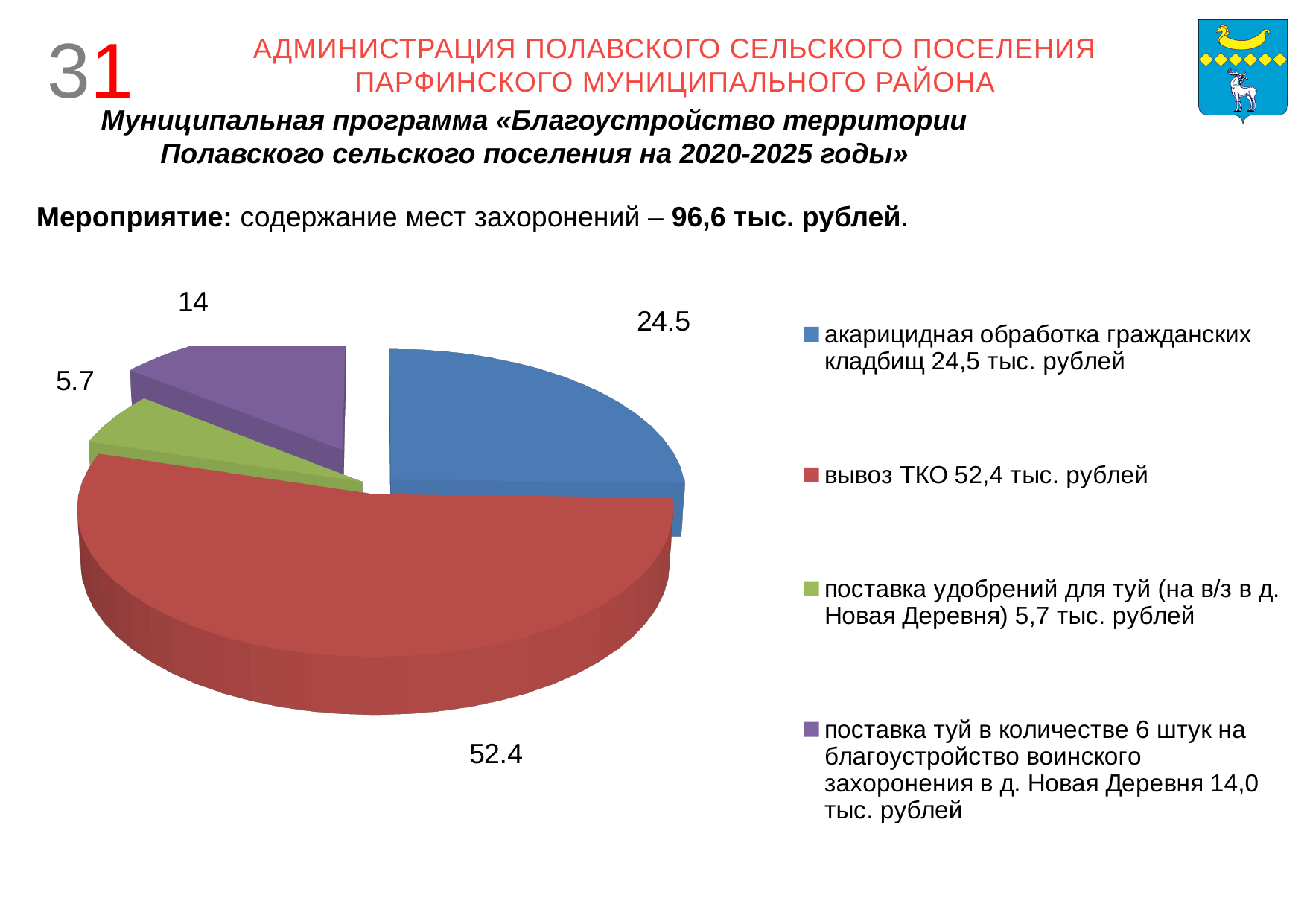
What type of chart is shown on the slide? pie chart Which is larger: акарицидная обработка гражданских кладбищ or поставка туй? акарицидная обработка гражданских кладбищ What is the value for поставка удобрений для туй? 5.7 What colour is the slice for вывоз ТКО? red What is the difference between the values for вывоз ТКО and акарицидная обработка гражданских кладбищ? 27.9 What is the value for поставка туй в количестве 6 штук? 14 What is the difference between the values for поставка туй and поставка удобрений для туй? 8.3 Which category has the smallest slice of the pie? поставка удобрений для туй Which category has the largest slice of the pie? вывоз ТКО What is the value for акарицидная обработка гражданских кладбищ? 24.5 What is the value for вывоз ТКО in the pie chart? 52.4 How many slices does the pie chart have? 4